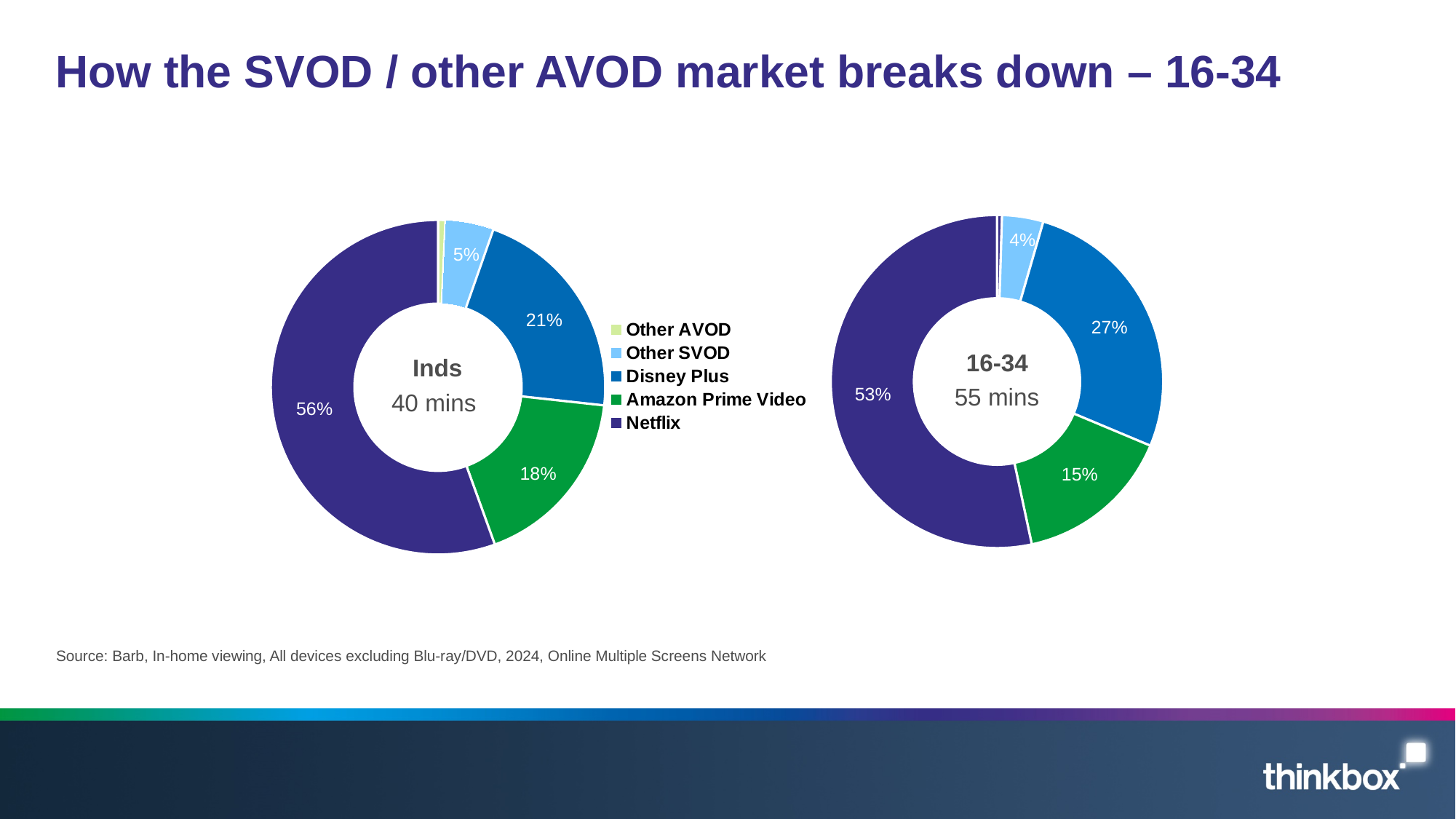
In the Inds chart, which is larger: Disney Plus or Amazon Prime Video? Disney Plus What viewing time is shown in the centre of the 16-34 chart? 55 mins In the Inds chart, what share does Other SVOD have? 5% In the 16-34 chart, which category has the largest share? Netflix Is Disney Plus's share larger in the Inds chart or in the 16-34 chart? 16-34 What is the difference between Netflix's share in the Inds chart and in the 16-34 chart? 3 percentage points In the Inds chart, which category has the smallest share? Other AVOD What kind of chart is used on this slide? Pie (donut) chart In the 16-34 chart, what share does Amazon Prime Video have? 15% In the 16-34 chart, what share does Disney Plus have? 27% How many categories does the legend list? 5 In the Inds chart, what share does Netflix have? 56%